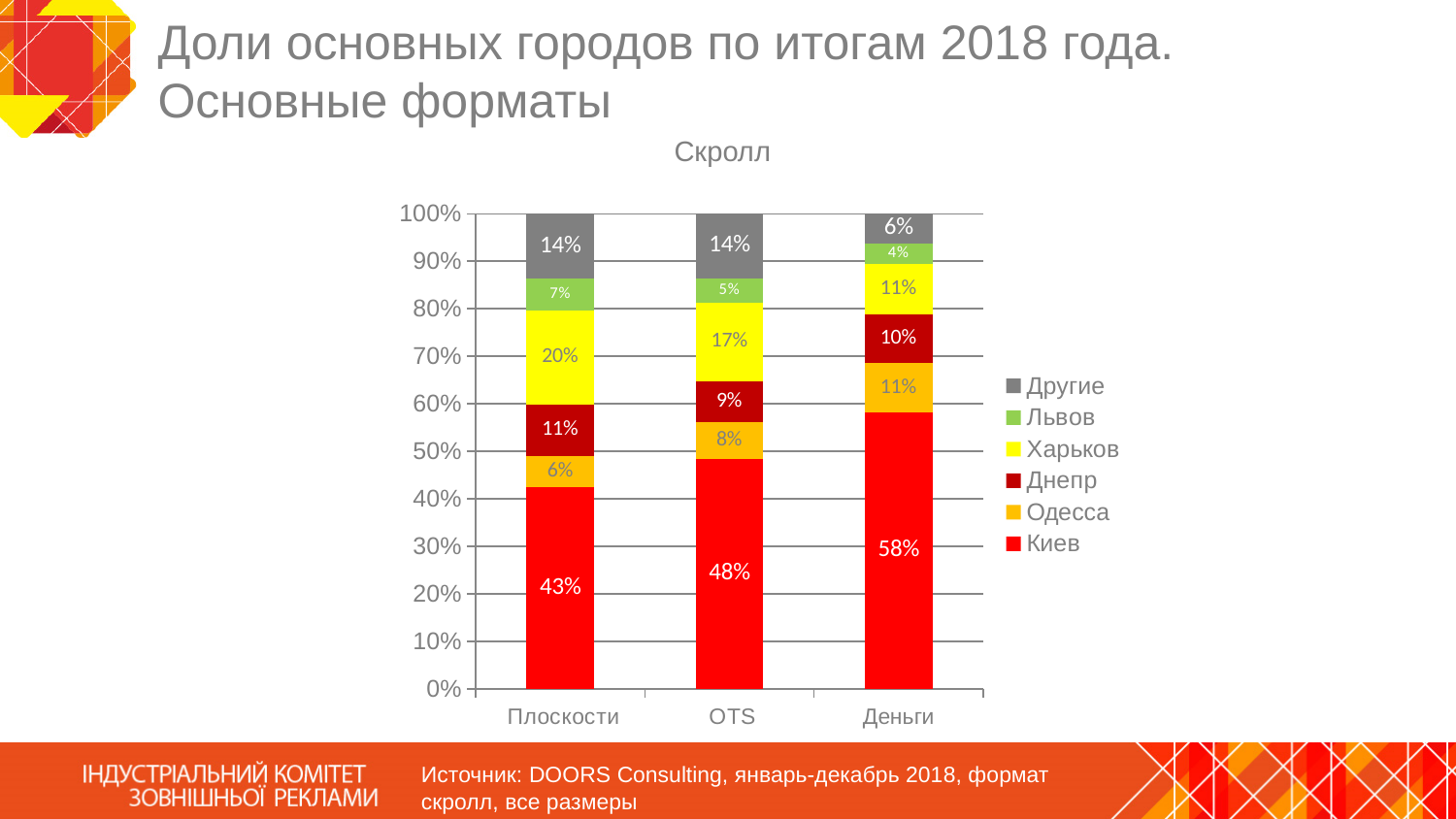
In which category does Киев have the highest share? Деньги What is the value for Киев in the Плоскости bar? 43% What is the value for Харьков in the OTS bar? 17% What is the title of the chart? Скролл What is the value for Одесса in the Деньги bar? 11% In which category does Львов have the lowest share? Деньги What is the difference between the Киев value for Деньги and the Киев value for Плоскости? 15% How many series does the legend list? 6 Which is larger: Харьков in Плоскости or Харьков in OTS? Харьков in Плоскости What is the value for Другие in the Деньги bar? 6% How many categories are shown on the x axis? 3 What kind of chart is shown on the slide? Stacked bar chart